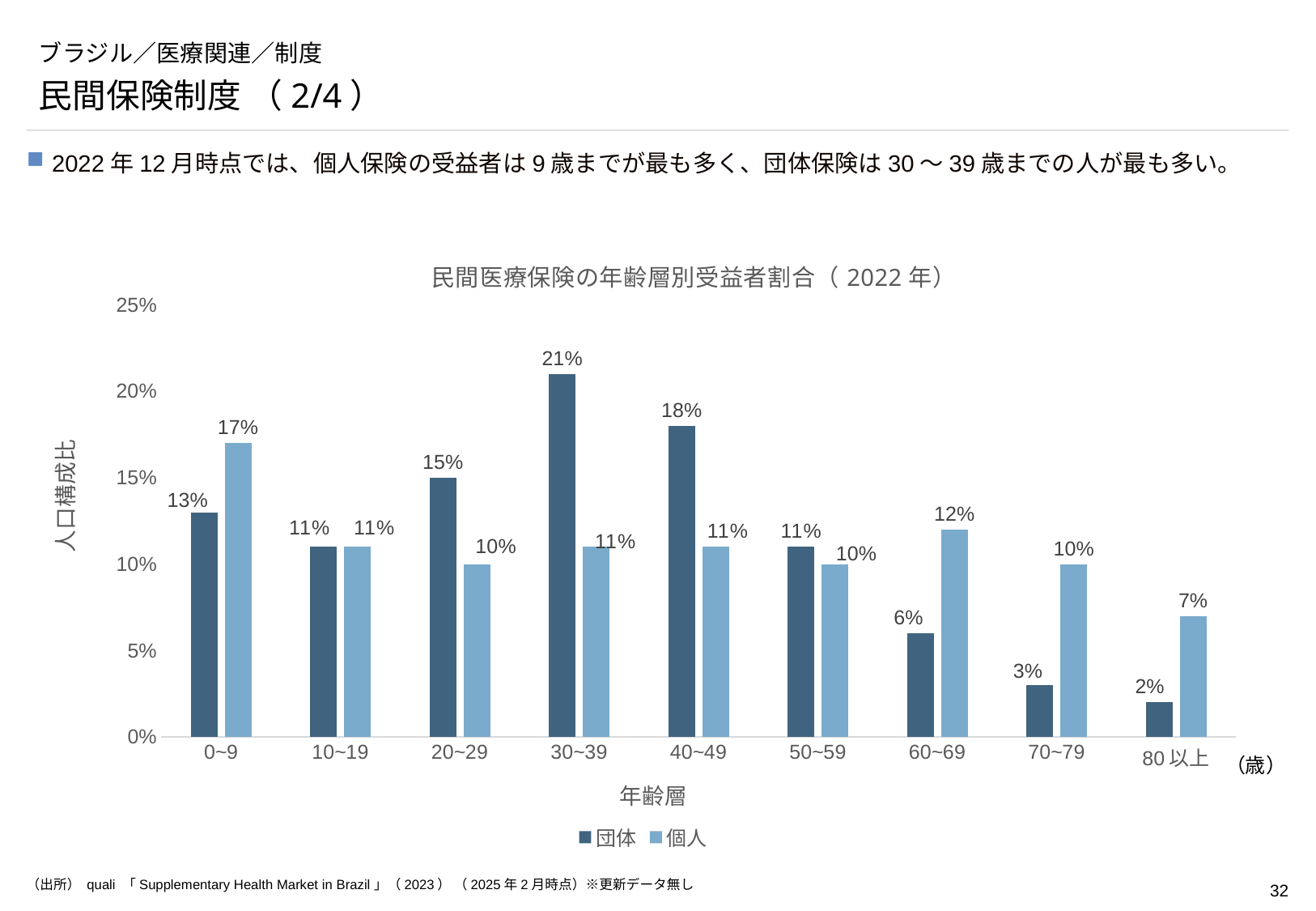
How many series does the legend list? 2 Which age group has the lowest value for 個人? 80以上 What is the value for 団体 in the 80以上 age group? 2% What is the difference between 団体 and 個人 in the 30~39 age group? 10% In the 60~69 age group, which series has the larger value, 団体 or 個人? 個人 Does the value for 団体 rise or fall from the 40~49 age group to the 80以上 age group? Fall What is the value for 個人 in the 0~9 age group? 17% How many age groups are shown on the x axis? 9 What is the value for 団体 in the 30~39 age group? 21% What is the title of the chart? 民間医療保険の年齢層別受益者割合（2022年） What kind of chart is shown on the slide? Bar chart Which age group has the highest value for 団体? 30~39